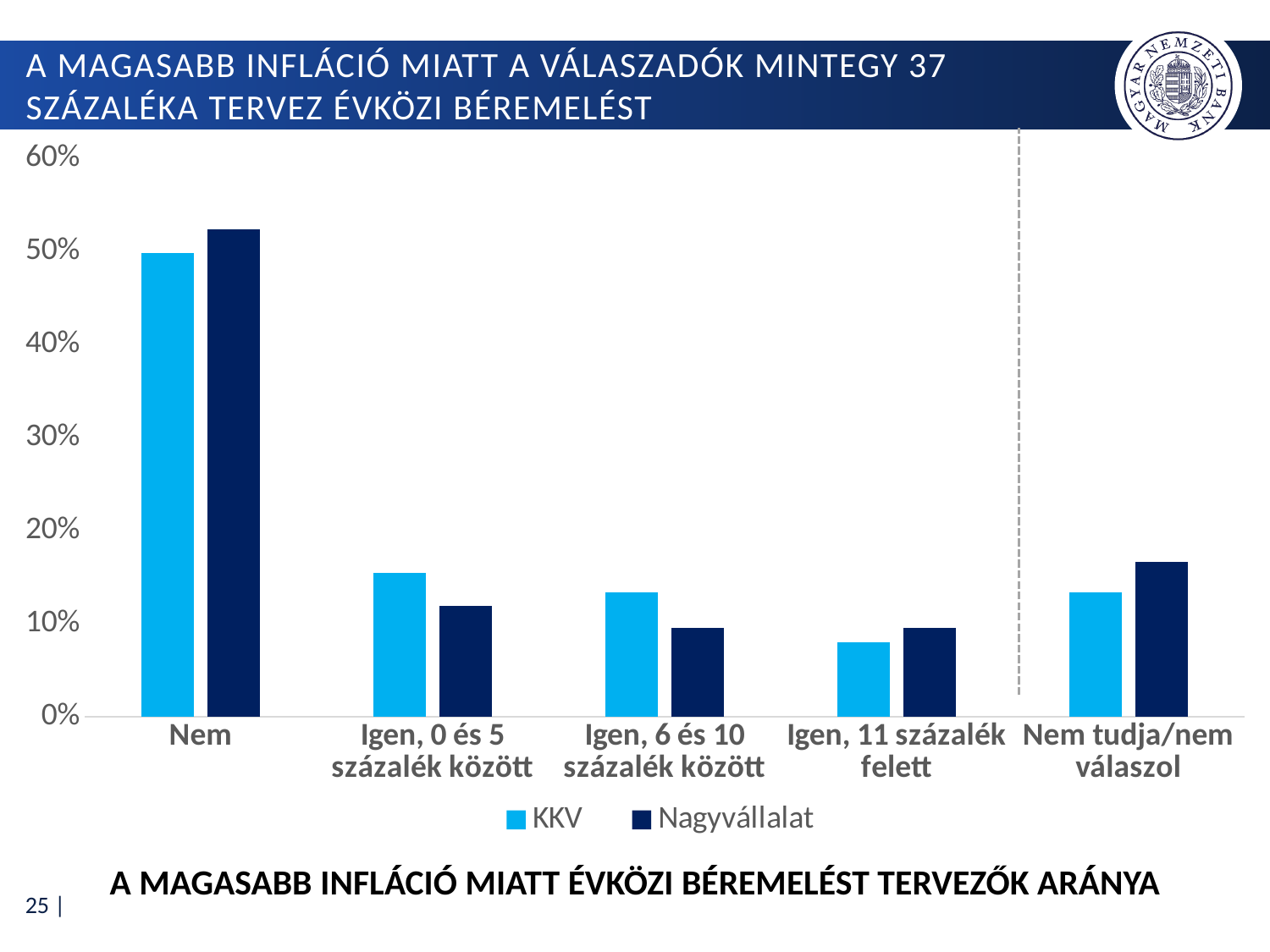
Is the KKV value for Igen, 11 százalék felett greater or less than 10%? less For the category Igen, 0 és 5 százalék között, which series has the larger value, KKV or Nagyvállalat? KKV Which category has the lowest KKV value? Igen, 11 százalék felett Is the KKV value for Igen, 0 és 5 százalék között greater or less than 20%? less Which category has the highest KKV value? Nem Which category has the highest Nagyvállalat value? Nem Is the KKV value for Nem greater or less than 40%? greater What kind of chart is shown on the slide? bar chart How many categories are shown on the x axis? 5 How many series does the legend list? 2 What are the two series named in the legend? KKV and Nagyvállalat